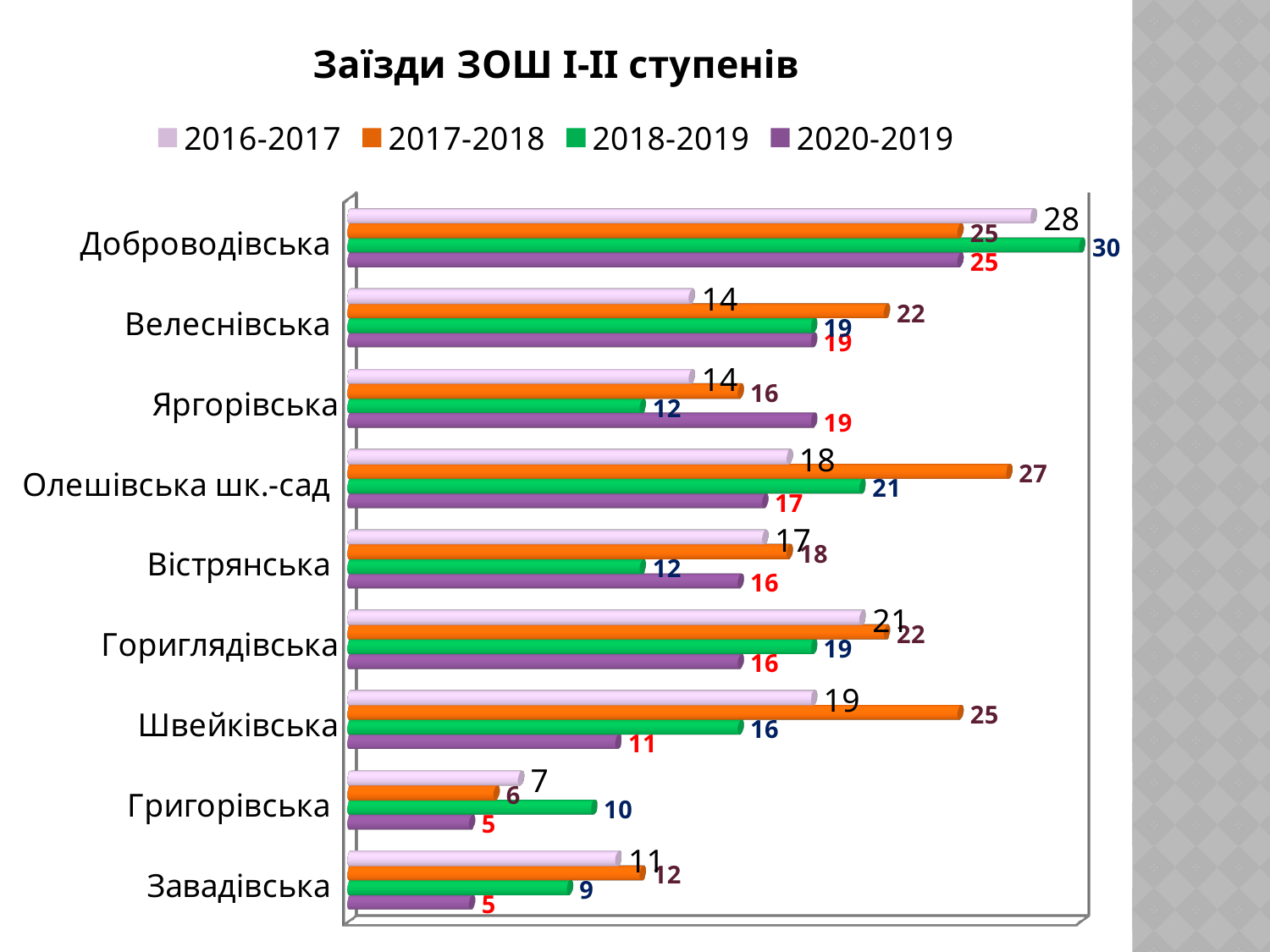
How many categories (schools) are shown on the chart? 9 Which is larger for Яргорівська: the 2018-2019 value or the 2020-2019 value? 2020-2019 How many series does the legend list? 4 What is the title of the chart? Заїзди ЗОШ І-ІІ ступенів What is the difference between the 2017-2018 and 2020-2019 values for Швейківська? 14 What is the difference between the 2016-2017 values for Доброводівська and Григорівська? 21 What is the value for Швейківська in the 2020-2019 series? 11 Which category has the highest value in the 2016-2017 series? Доброводівська What kind of chart is shown on the slide? Bar chart What is the value for Олешівська шк.-сад in the 2017-2018 series? 27 Which category has the lowest value in the 2018-2019 series? Завадівська What is the value for Доброводівська in the 2018-2019 series? 30